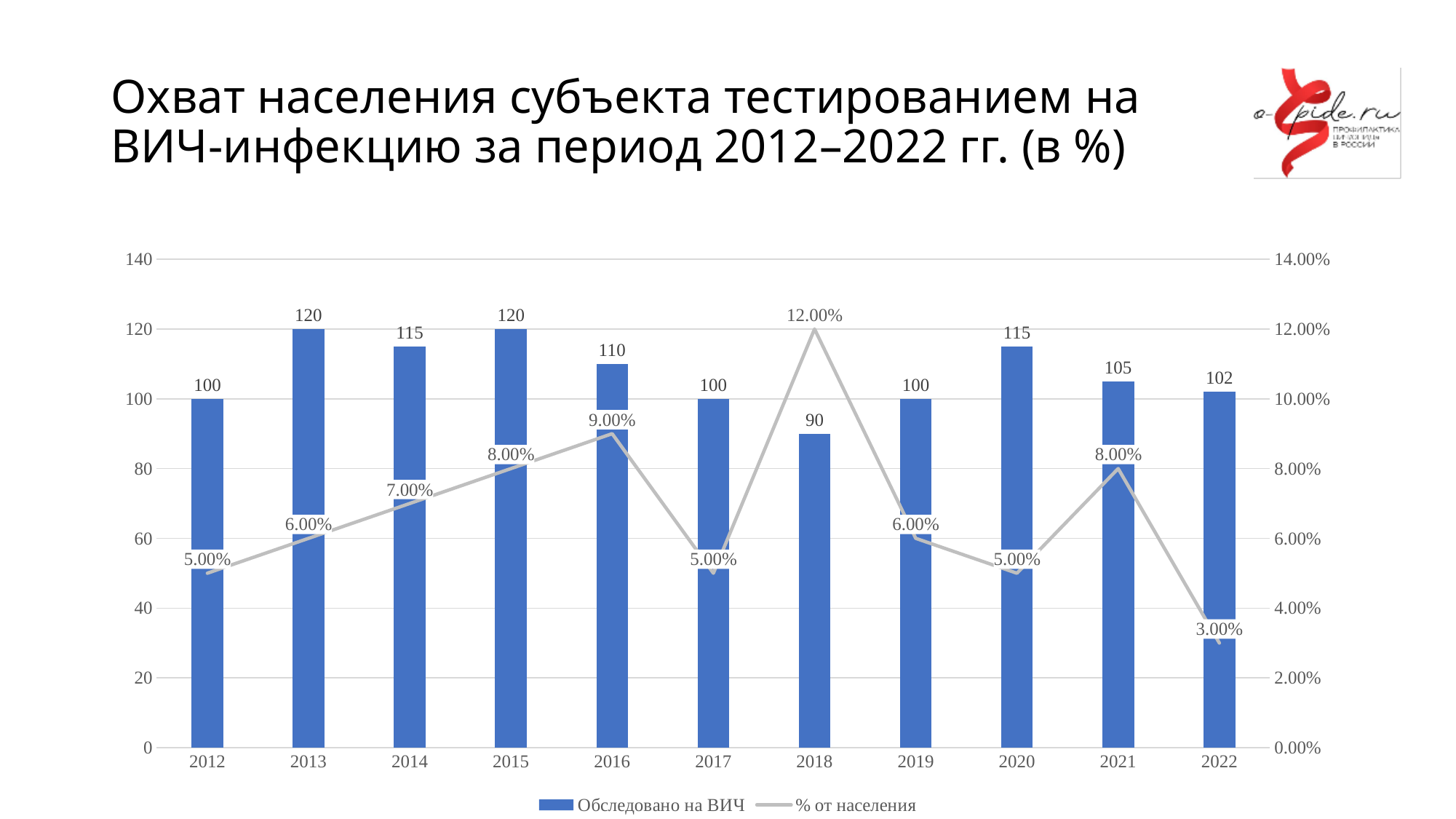
Which year has the lowest "Обследовано на ВИЧ" value? 2018 Does the "% от населения" value rise or fall from 2012 to 2016? Rise What kinds of chart are combined on this slide? Bar chart and line chart How many years are shown on the x axis? 11 What is the value of "Обследовано на ВИЧ" for 2022? 102 Which year has the highest "% от населения" value? 2018 What is the "% от населения" value for 2016? 9.00% How many series does the legend list? 2 Which is larger, the "Обследовано на ВИЧ" value for 2014 or for 2016? 2014 What is the difference between the "Обследовано на ВИЧ" values for 2013 and 2021? 15 What is the value of "Обследовано на ВИЧ" for 2018? 90 Which year has the lowest "% от населения" value? 2022